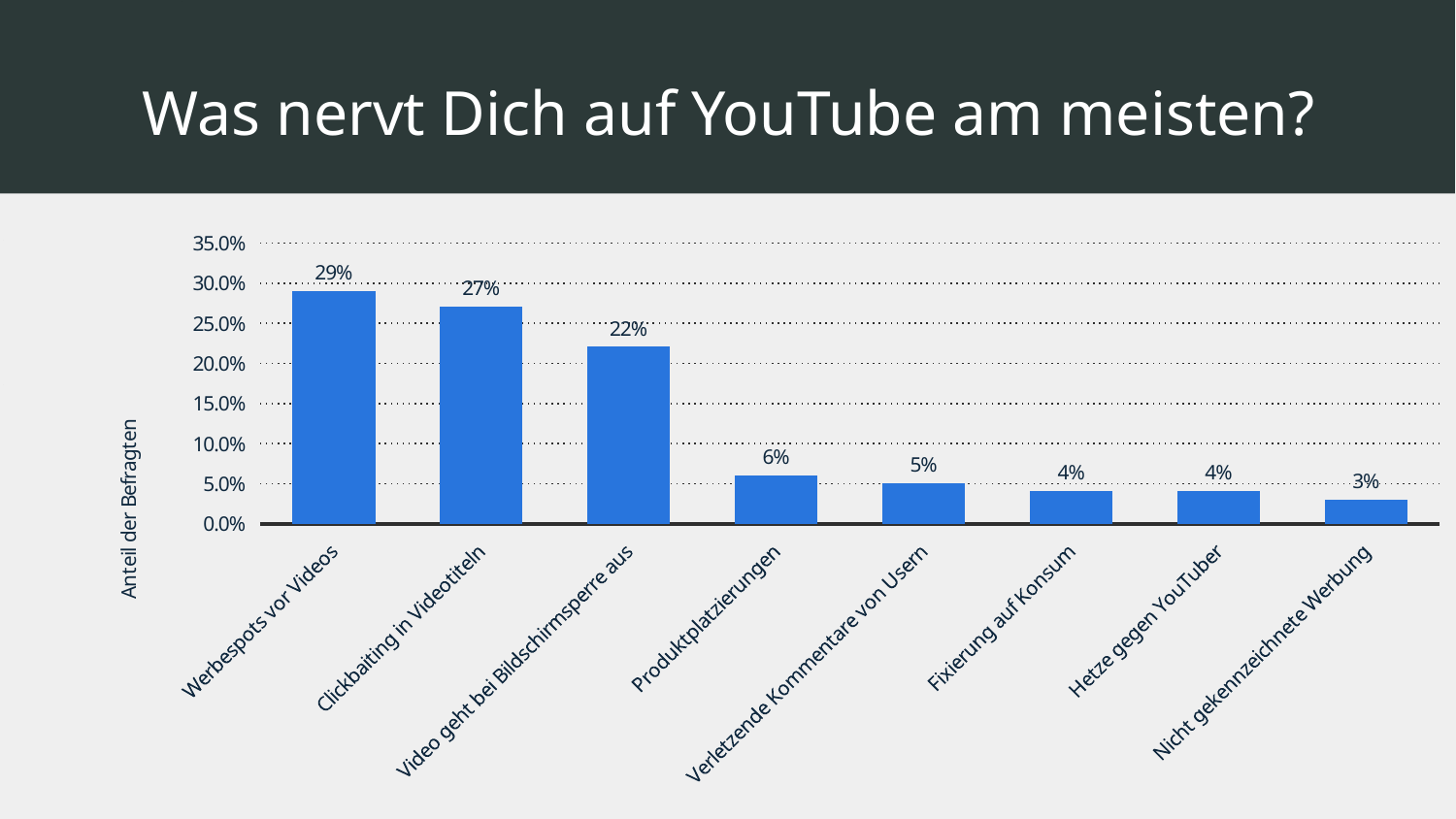
What is the value for Verletzende Kommentare von Usern? 5% Is the value for Video geht bei Bildschirmsperre aus greater or less than 25.0%? less What is the value for Video geht bei Bildschirmsperre aus? 22% Which category has the highest value? Werbespots vor Videos What kind of chart is shown on the slide? bar chart Which is larger, the value for Werbespots vor Videos or the value for Clickbaiting in Videotiteln? Werbespots vor Videos Do the values rise or fall from left to right along the x axis? fall What is the title of the chart? Was nervt Dich auf YouTube am meisten? Which category has the lowest value? Nicht gekennzeichnete Werbung How many categories are shown on the x axis? 8 What is the value for Werbespots vor Videos? 29% What is the difference between the values for Clickbaiting in Videotiteln and Produktplatzierungen? 21%